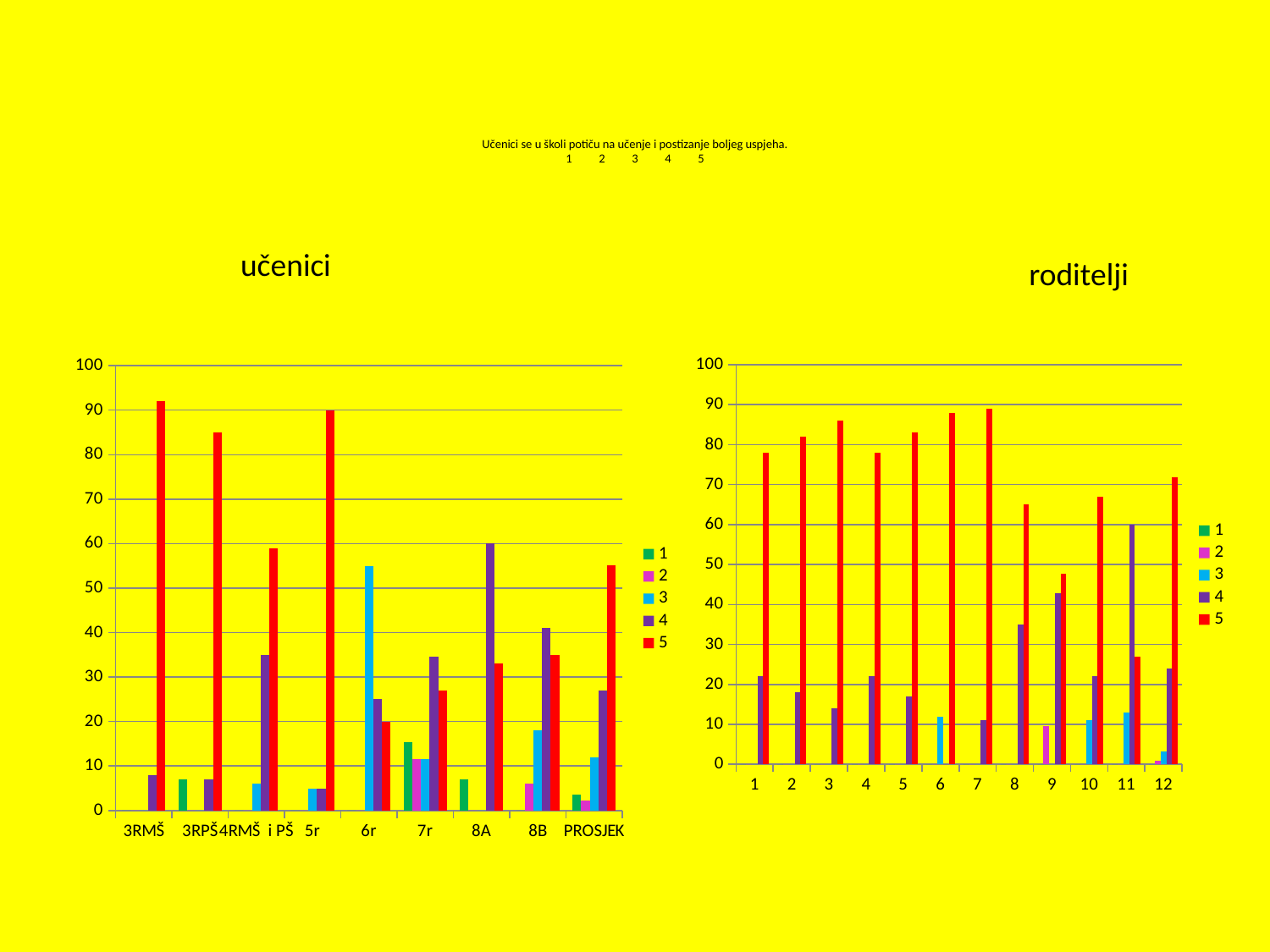
In the "učenici" chart, is the value of series 4 larger for 8A or for 8B? 8A In the "roditelji" chart, which category has the lowest value for series 5? 11 How many categories are shown on the x axis of the "učenici" chart? 9 How many series does the legend of the "roditelji" chart list? 5 In the "roditelji" chart, is the value of series 5 for category 7 greater or less than 80? greater What colour are the bars for series 5 in the "roditelji" chart? red How many categories are shown on the x axis of the "roditelji" chart? 12 What kind of chart is the "učenici" chart? bar chart In the "učenici" chart, is the value of series 3 for 6r greater or less than 50? greater In the "roditelji" chart, is the value of series 5 for category 9 greater or less than 50? less In the "učenici" chart, which category has the lowest value for series 5? 6r